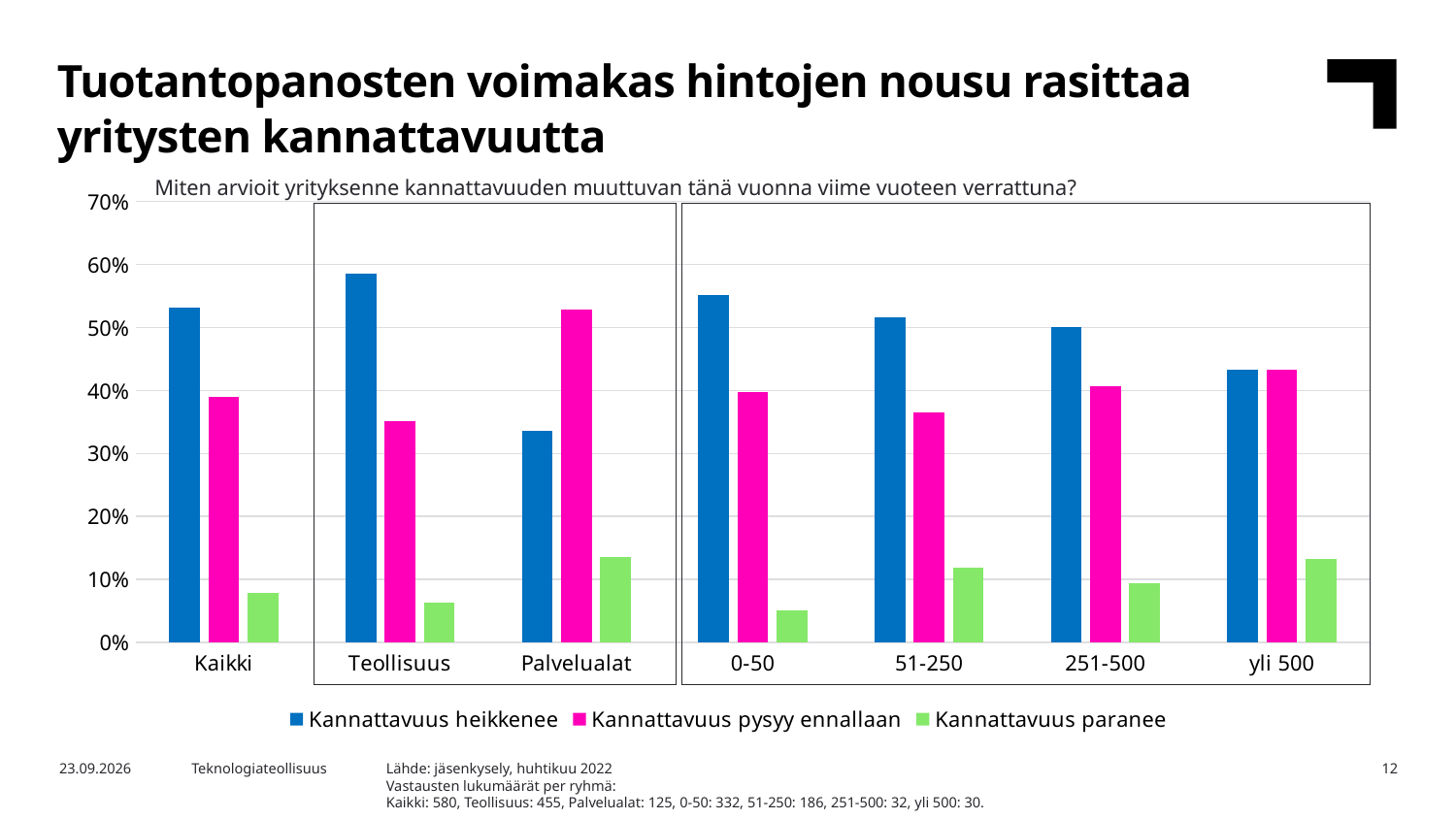
Is the value for 'Kannattavuus heikkenee' in Teollisuus greater or less than 50%? greater How many categories are shown on the x axis? 7 How many series does the legend list? 3 Is the value for 'Kannattavuus paranee' in Kaikki greater or less than 10%? less Is the value for 'Kannattavuus pysyy ennallaan' in Palvelualat greater or less than 50%? greater Which series is shown in green in the legend? Kannattavuus paranee Which category has the highest value for 'Kannattavuus heikkenee'? Teollisuus In the Kaikki category, which is larger: 'Kannattavuus heikkenee' or 'Kannattavuus pysyy ennallaan'? Kannattavuus heikkenee Which category has the lowest value for 'Kannattavuus heikkenee'? Palvelualat Which category has the highest value for 'Kannattavuus pysyy ennallaan'? Palvelualat What kind of chart is shown on the slide? bar chart